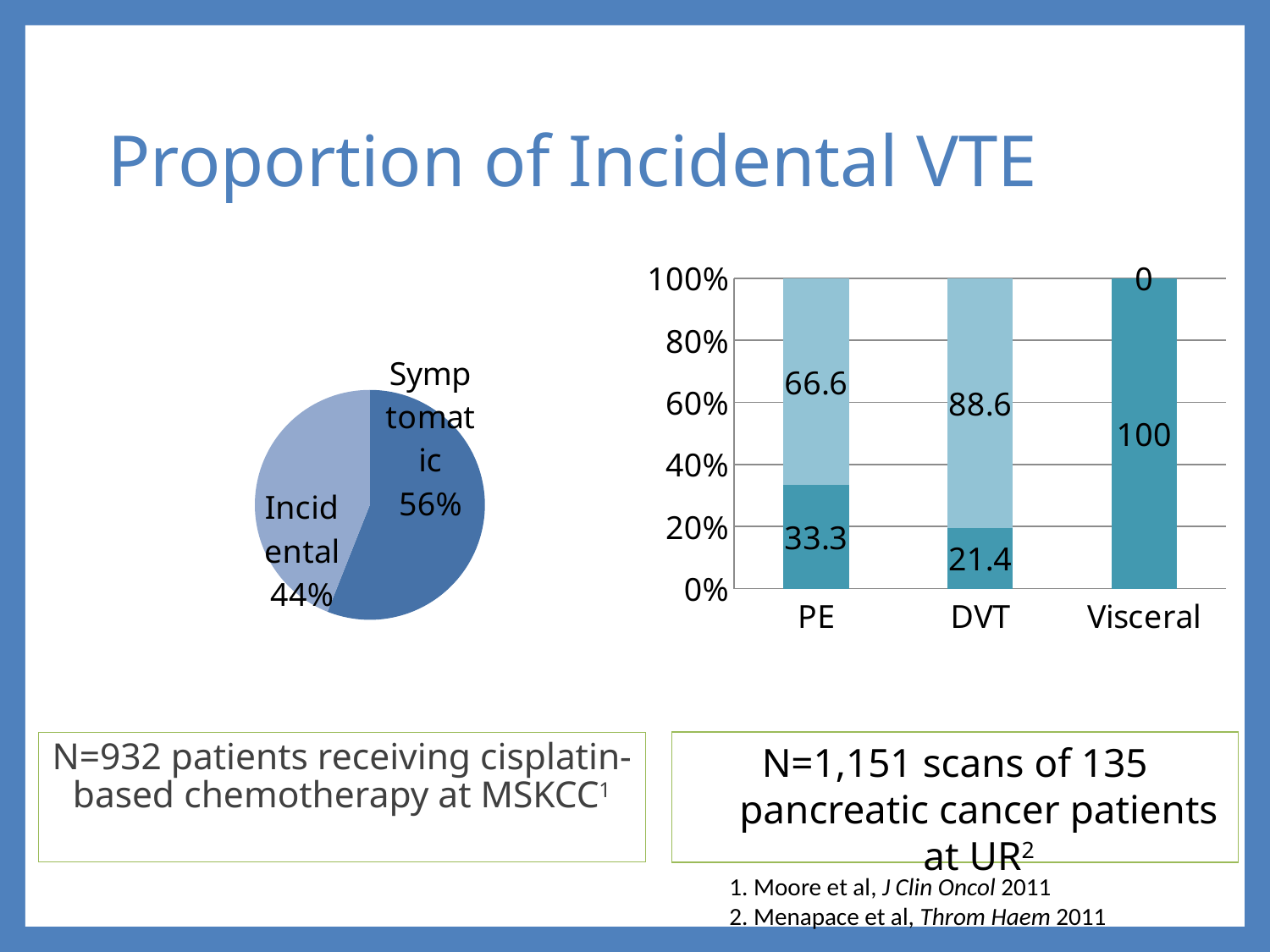
In the bar chart on the right, what is the value of the lower (darker) segment of the Visceral bar? 100 In the bar chart on the right, what is the value of the lower (darker) segment of the PE bar? 33.3 In the pie chart on the left, which slice is larger, Incidental or Symptomatic? Symptomatic What kind of chart is on the right of the slide? bar chart What kind of chart is on the left of the slide? pie chart In the bar chart on the right, what is the difference between the lower segment values of PE and DVT? 11.9 In the bar chart on the right, how many categories are shown on the x axis? 3 In the pie chart on the left, what share is labelled Incidental? 44% In the bar chart on the right, what is the value of the upper (lighter) segment of the DVT bar? 88.6 In the pie chart on the left, what share is labelled Symptomatic? 56% In the bar chart on the right, which category has the highest value for the lower (darker) segment? Visceral How many slices does the pie chart on the left have? 2